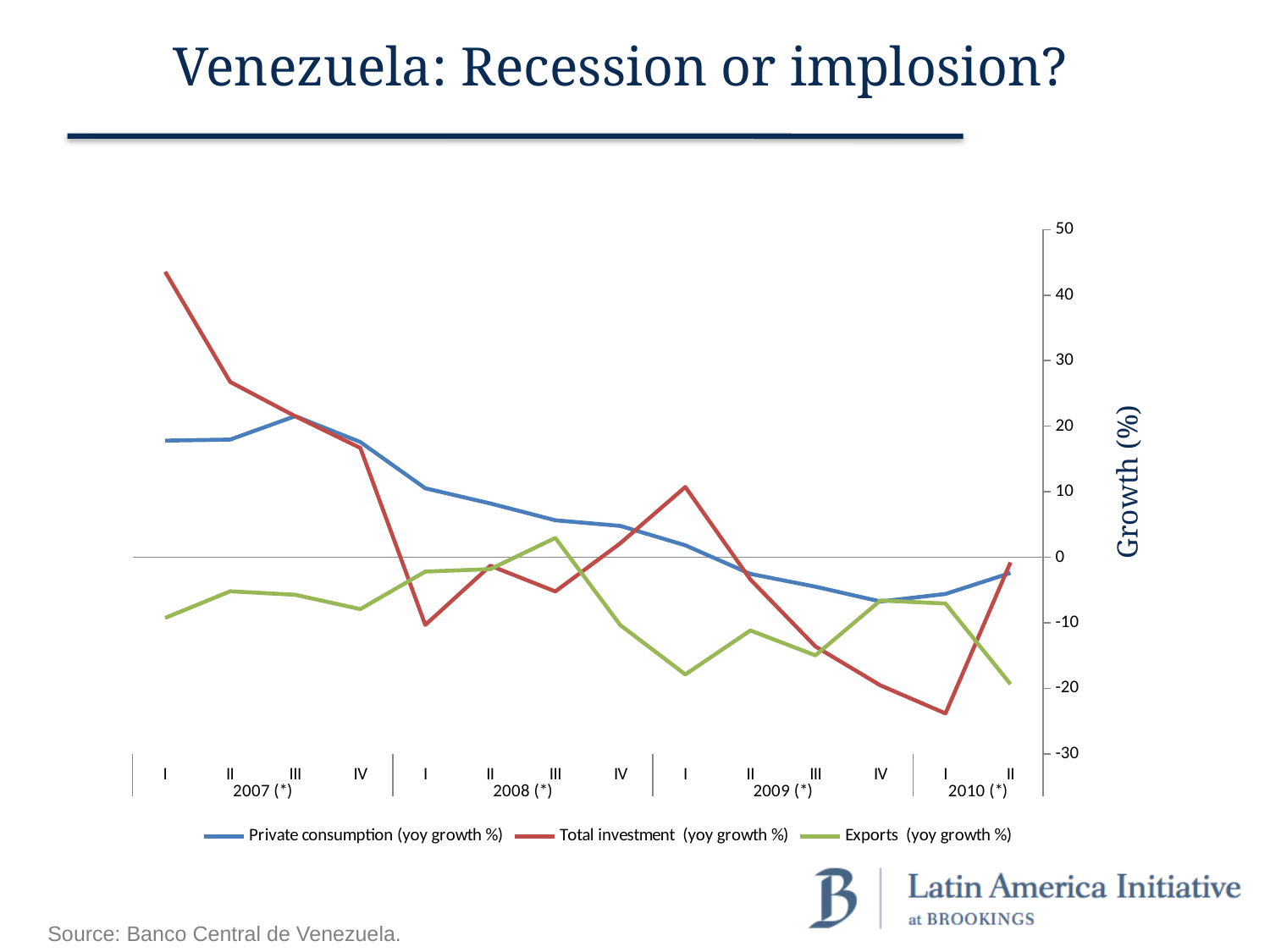
In quarter II of 2010, which is higher: Exports (yoy growth %) or Total investment (yoy growth %)? Total investment (yoy growth %) Is the value for Private consumption (yoy growth %) in quarter I of 2007 greater or less than 20? less How many quarterly data points are plotted along the x axis? 14 In quarter I of 2010, which series has the lowest value? Total investment (yoy growth %) What kind of chart is shown on the slide? Line chart Is the value for Exports (yoy growth %) in quarter I of 2009 greater or less than -10? less In quarter I of 2007, which series has the highest value? Total investment (yoy growth %) What is the label on the vertical axis of the chart? Growth (%) Is the value for Total investment (yoy growth %) in quarter I of 2010 greater or less than -20? less Does Private consumption (yoy growth %) generally rise or fall from quarter I of 2007 to quarter IV of 2009? fall How many series does the legend list? 3